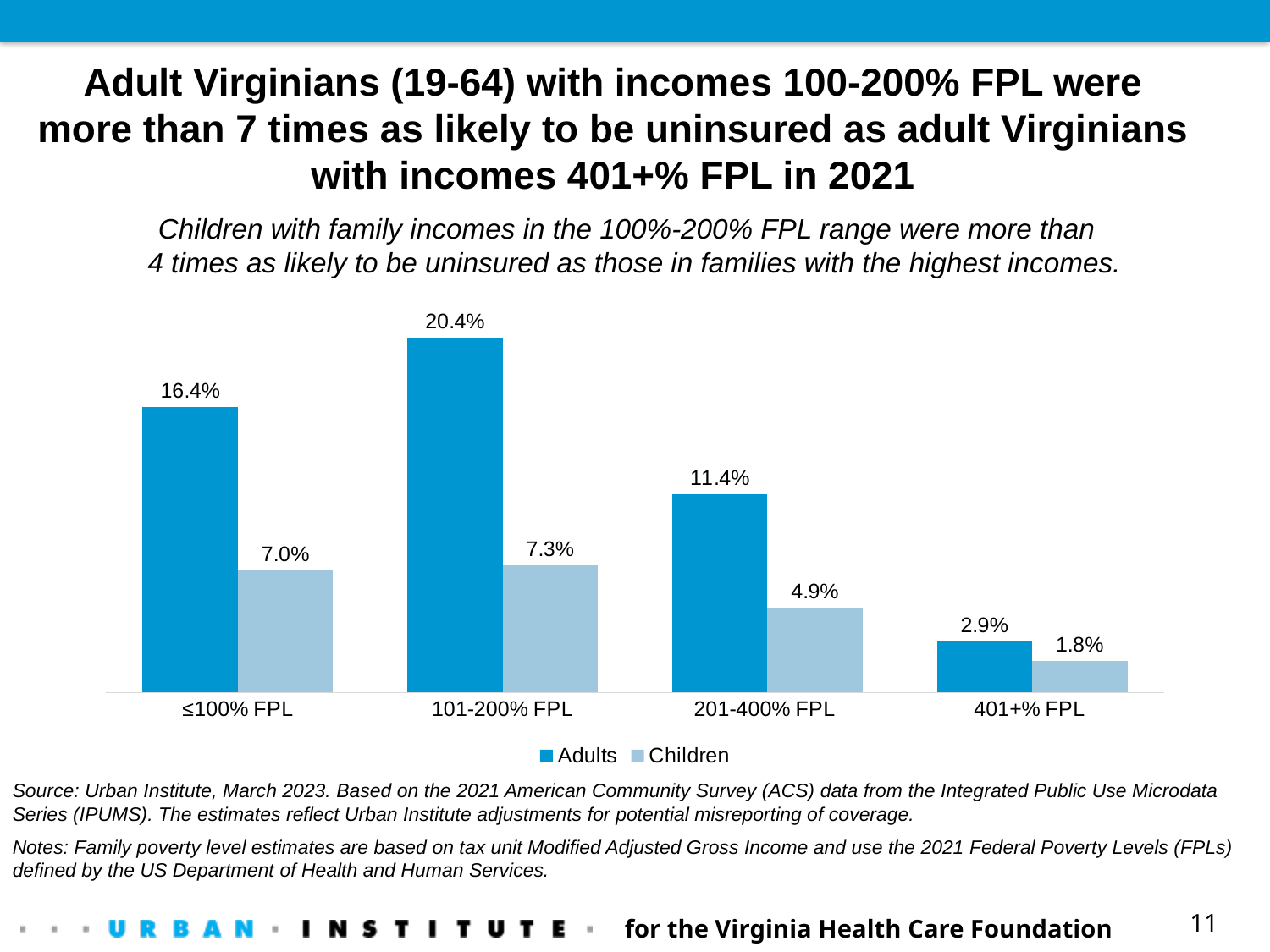
Which is larger: the Adults rate for ≤100% FPL or the Adults rate for 201-400% FPL? ≤100% FPL What is the uninsured rate for Children with incomes ≤100% FPL? 7.0% Which income category has the highest uninsured rate for Adults? 101-200% FPL What is the uninsured rate for Adults with incomes 101-200% FPL? 20.4% How many income categories are shown on the x axis? 4 What kind of chart is shown on the slide? Bar chart Which series is shown in the darker blue colour? Adults How many series does the legend list? 2 What is the uninsured rate for Children with incomes 401+% FPL? 1.8% What is the difference between the Adults and Children uninsured rates for 201-400% FPL? 6.5 percentage points Which income category has the lowest uninsured rate for Children? 401+% FPL Do the Children uninsured rates rise or fall from 101-200% FPL to 401+% FPL? Fall